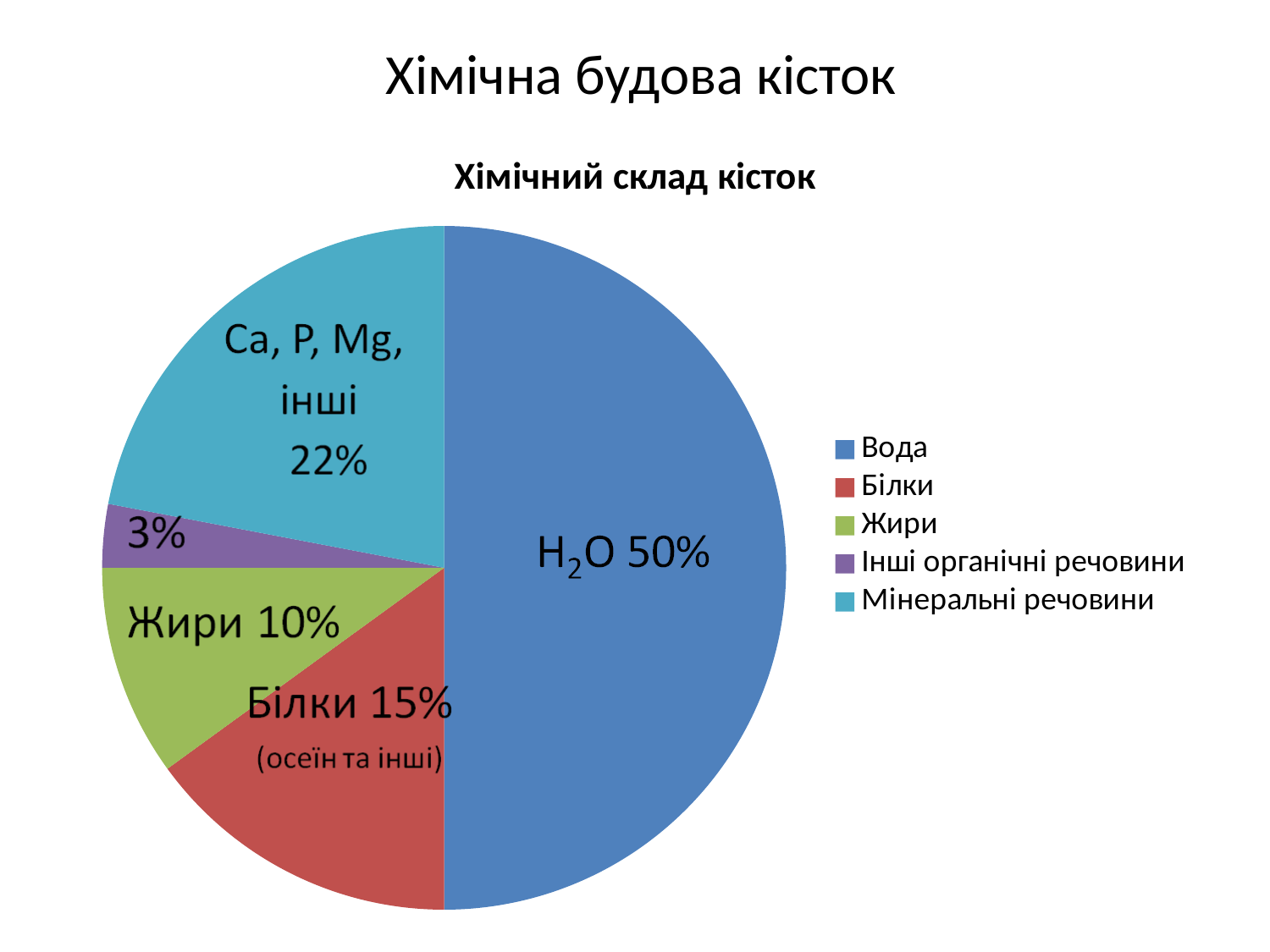
What share of the pie does Білки take? 15% What is the chart's title? Хімічний склад кісток Which category has the largest slice of the pie? Вода Which is larger, the share of Жири or the share of Білки? Білки What share of the pie does Жири take? 10% How many categories does the legend list? 5 What is the difference between the shares of Мінеральні речовини and Білки? 7% Which category has the smallest slice of the pie? Інші органічні речовини What share of the pie does Вода (H2O) take? 50% What kind of chart is shown on the slide? pie chart